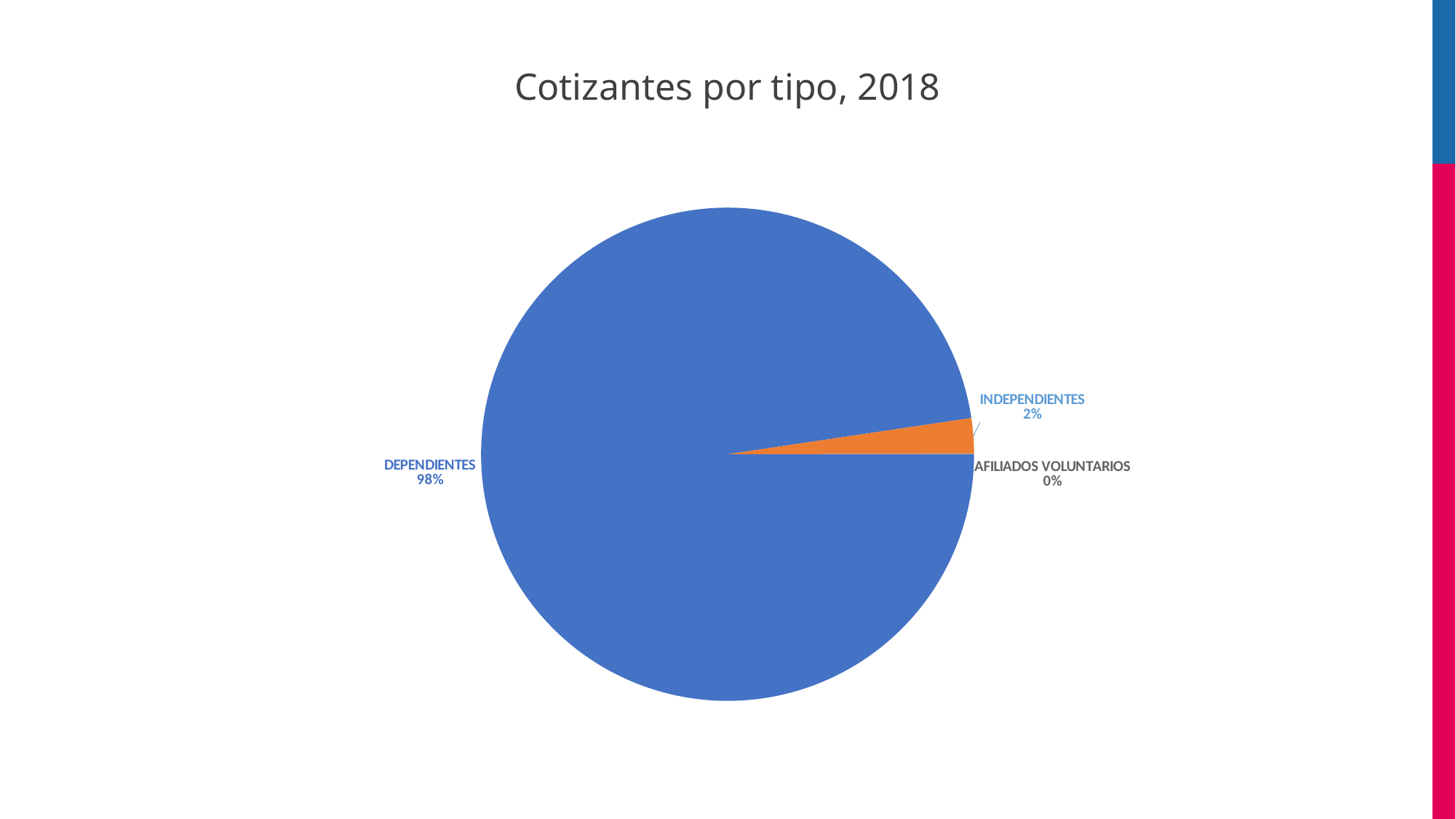
How many categories are shown in the pie chart? 3 What is the title of the chart? Cotizantes por tipo, 2018 What share of the pie does INDEPENDIENTES represent? 2% What is the difference in percentage points between DEPENDIENTES and INDEPENDIENTES? 96 Is the share for DEPENDIENTES greater or less than 50%? greater What kind of chart is shown on the slide? Pie chart Which is larger, the share for INDEPENDIENTES or the share for AFILIADOS VOLUNTARIOS? INDEPENDIENTES Which category has the largest slice of the pie? DEPENDIENTES What percentage is shown for AFILIADOS VOLUNTARIOS? 0% What share of the pie does DEPENDIENTES represent? 98% Which category has the smallest slice of the pie? AFILIADOS VOLUNTARIOS What colour is the DEPENDIENTES slice? Blue